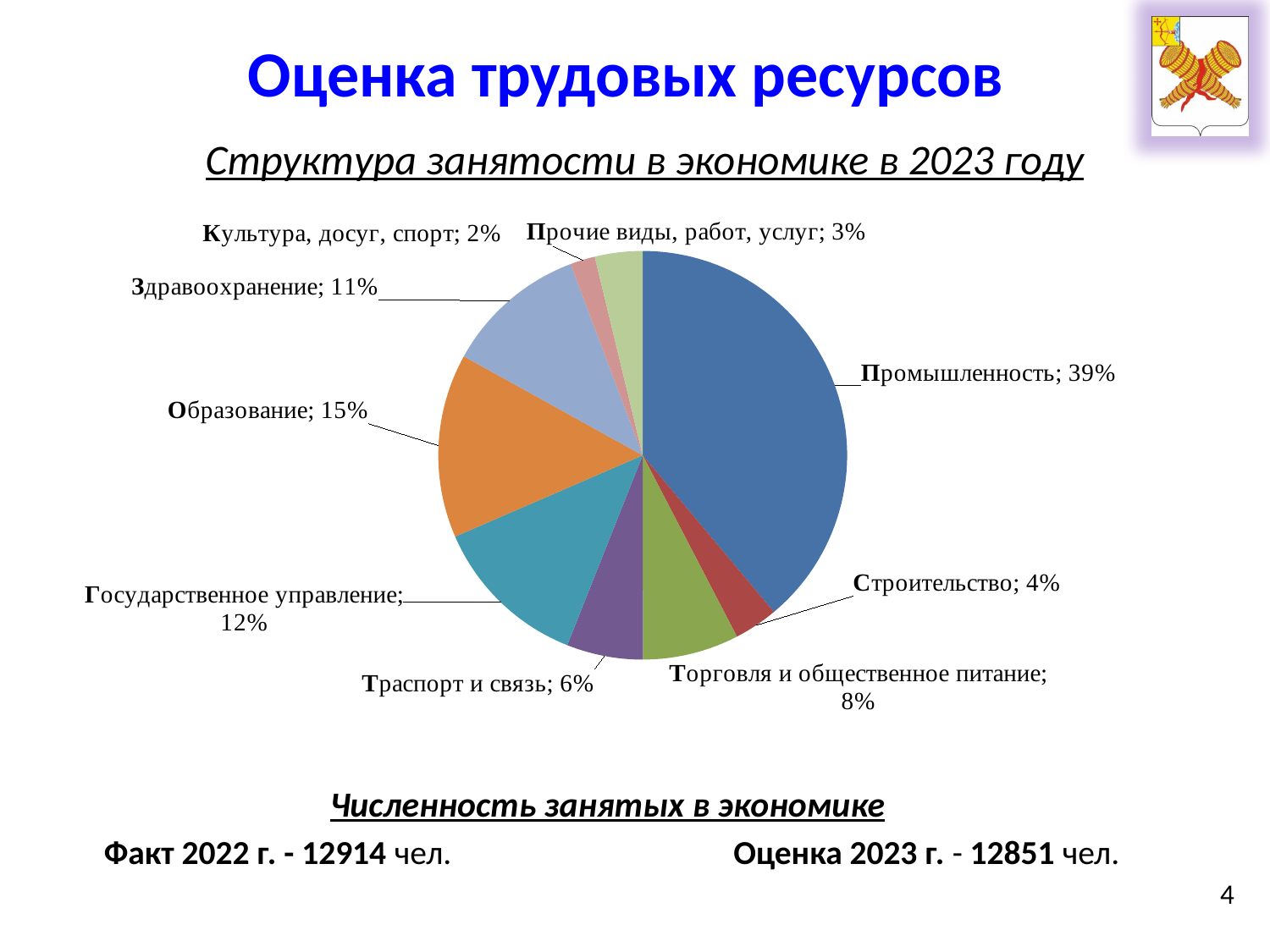
What is the difference between the shares of Промышленность and Образование? 24% How many slices does the pie chart have? 9 Which sector has the smallest slice of the pie? Культура, досуг, спорт What share of employment does Промышленность have in the pie chart? 39% Which is larger: the share of Торговля и общественное питание or Траспорт и связь? Торговля и общественное питание What kind of chart is shown on the slide? Pie chart What is the title of the pie chart? Структура занятости в экономике в 2023 году Which sector has the largest slice of the pie? Промышленность What is the combined share of Строительство and Прочие виды, работ, услуг? 7% What percentage is shown for Здравоохранение? 11% What is the value for Государственное управление? 12% What is the value shown for Образование? 15%